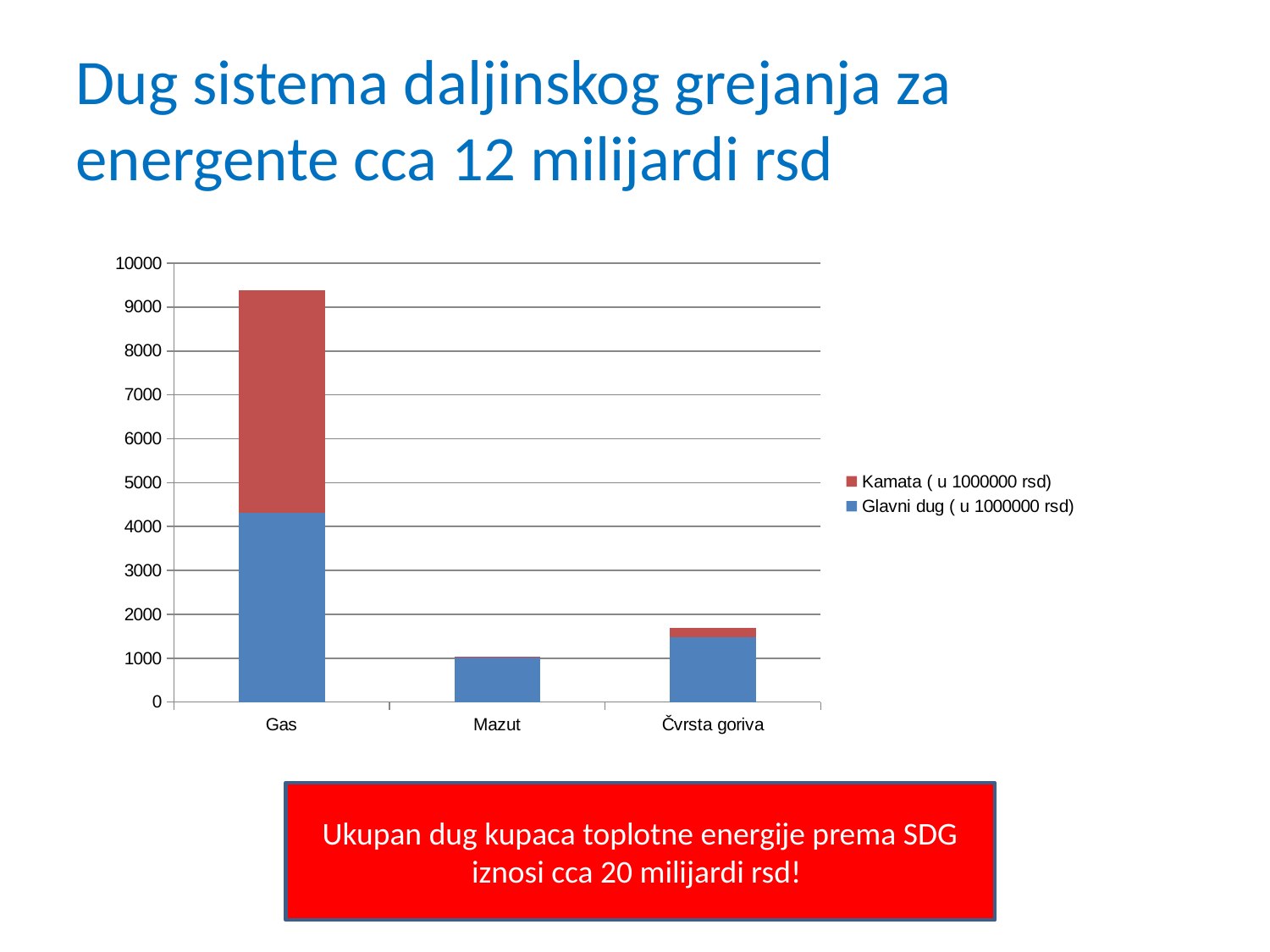
How many series does the chart legend list? 2 Which category has the highest total bar in the chart? Gas Is the total bar for Gas greater or less than 9000? greater How many categories are shown on the x axis of the chart? 3 For Gas, which series segment is larger, Kamata ( u 1000000 rsd) or Glavni dug ( u 1000000 rsd)? Kamata ( u 1000000 rsd) Is the Glavni dug ( u 1000000 rsd) value for Čvrsta goriva greater or less than 1000? greater Which category has a larger total bar, Mazut or Čvrsta goriva? Čvrsta goriva Is the total bar for Čvrsta goriva greater or less than 2000? less What kind of chart is shown on the slide? Stacked bar chart Which category has the lowest total bar in the chart? Mazut Which colour represents the Kamata ( u 1000000 rsd) series in the chart? Red